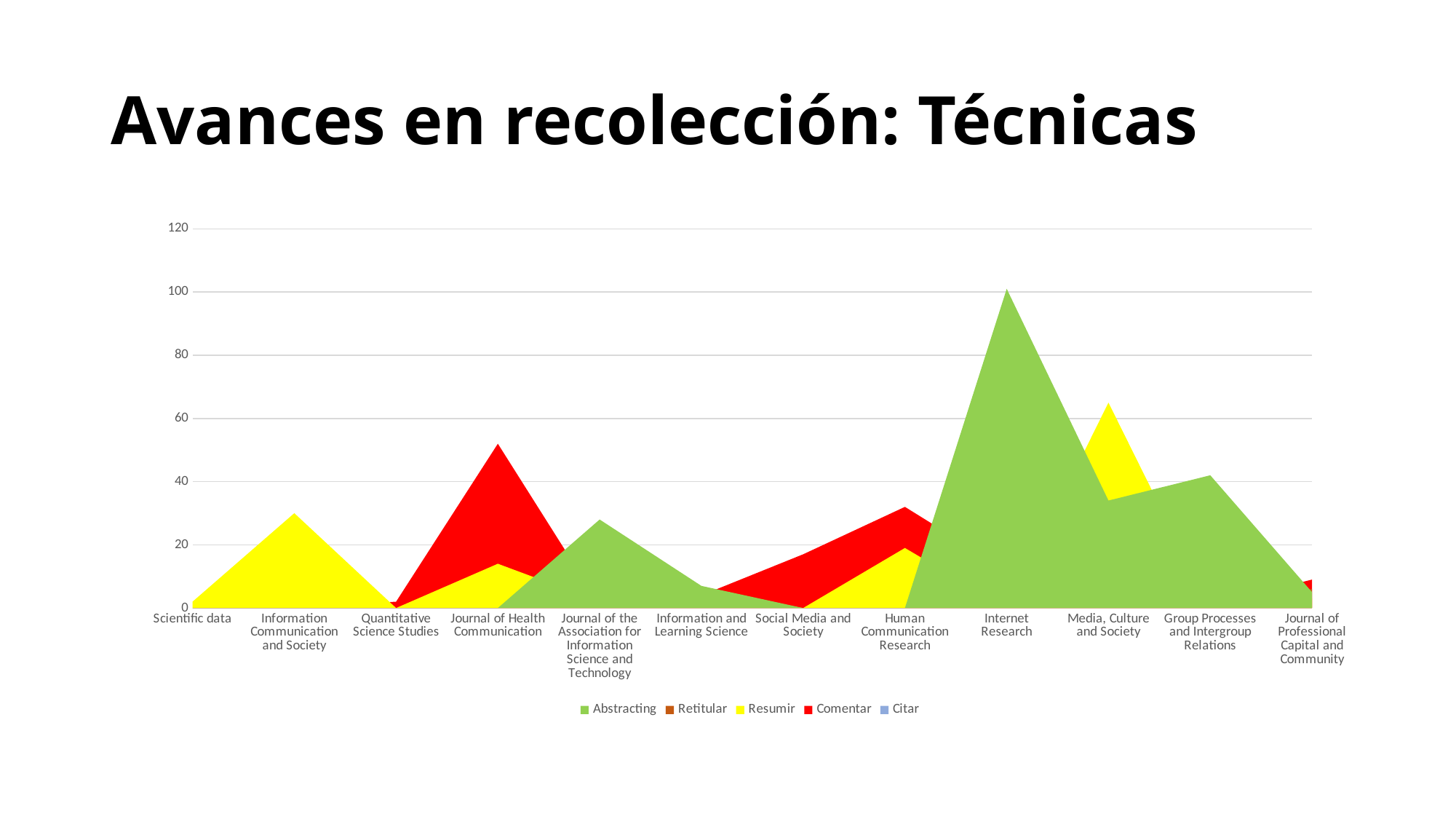
What kind of chart is shown on the slide? area chart For which category does the Resumir series reach its highest value? Media, Culture and Society For which category does the Abstracting series reach its highest value? Internet Research For which category does the Comentar series reach its highest value? Journal of Health Communication Is the Abstracting value for Journal of the Association for Information Science and Technology greater or less than 40? less Which is larger: the Abstracting value for Internet Research or for Media, Culture and Society? Internet Research How many series does the chart legend list? 5 Which is larger: the Resumir value for Information Communication and Society or for Media, Culture and Society? Media, Culture and Society What colour represents the Abstracting series in the chart? green Is the Comentar value for Journal of Health Communication greater or less than 40? greater How many categories are shown along the x axis of the chart? 12 Is the Abstracting value for Internet Research greater or less than 80? greater